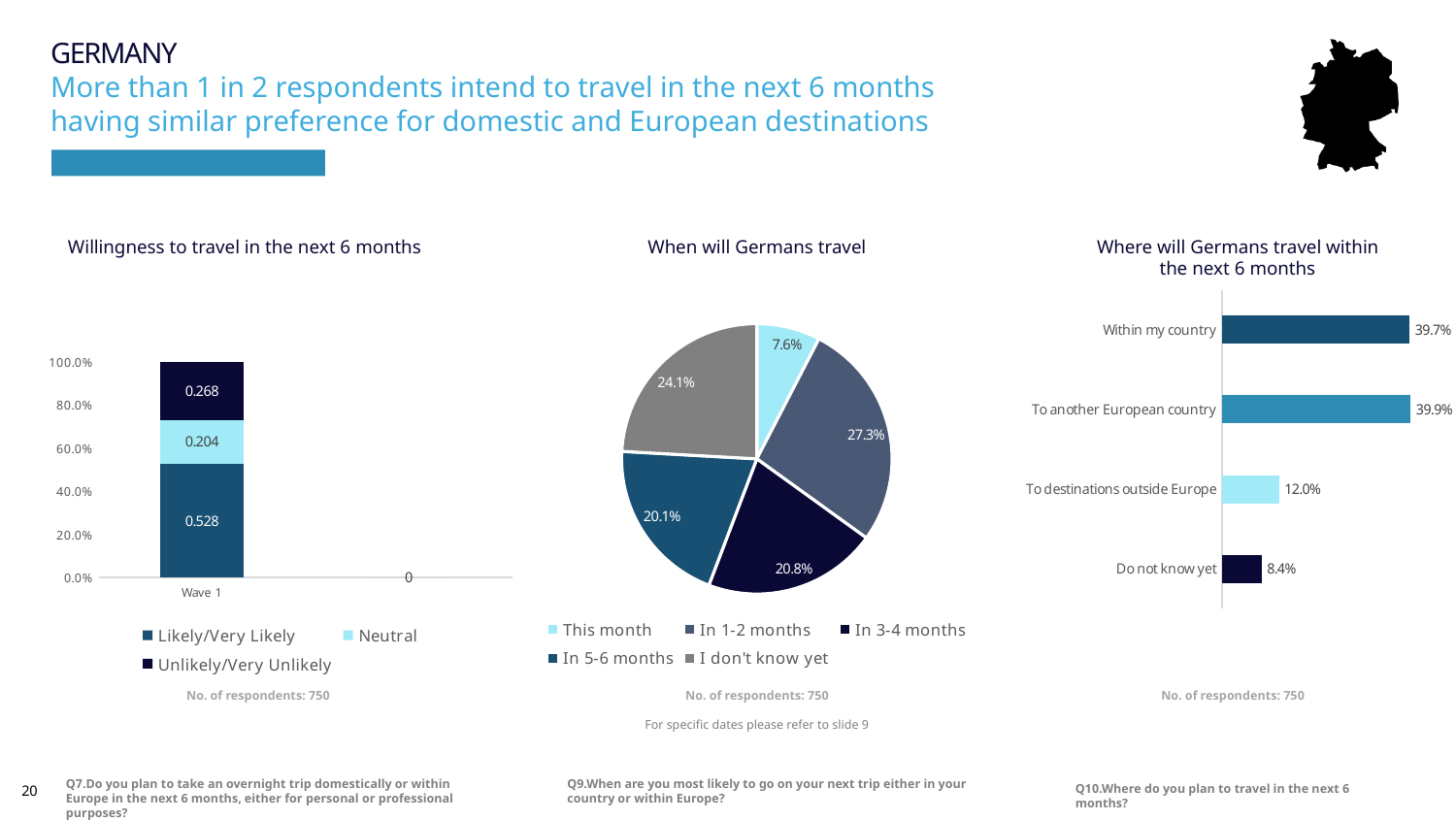
In the 'When will Germans travel' pie chart, which category has the smallest share? This month What kind of chart is 'When will Germans travel'? Pie chart In the 'Where will Germans travel within the next 6 months' chart, what is the value for 'To destinations outside Europe'? 12.0% In the 'When will Germans travel' pie chart, what is the value for 'I don't know yet'? 24.1% In the 'Willingness to travel in the next 6 months' chart, what is the difference between the Likely/Very Likely and Unlikely/Very Unlikely values? 0.260 In the 'Where will Germans travel within the next 6 months' chart, what is the difference between 'To another European country' and 'Within my country'? 0.2% In the 'Willingness to travel in the next 6 months' chart, what is the value for Neutral? 0.204 In the 'When will Germans travel' pie chart, how many slices are there? 5 In the 'When will Germans travel' pie chart, what share of respondents plan to travel in 1-2 months? 27.3% In the 'Where will Germans travel within the next 6 months' chart, which category has the lowest value? Do not know yet In the 'Willingness to travel in the next 6 months' chart, how many series does the legend list? 3 In the 'Willingness to travel in the next 6 months' chart, what is the value for Likely/Very Likely in Wave 1? 0.528